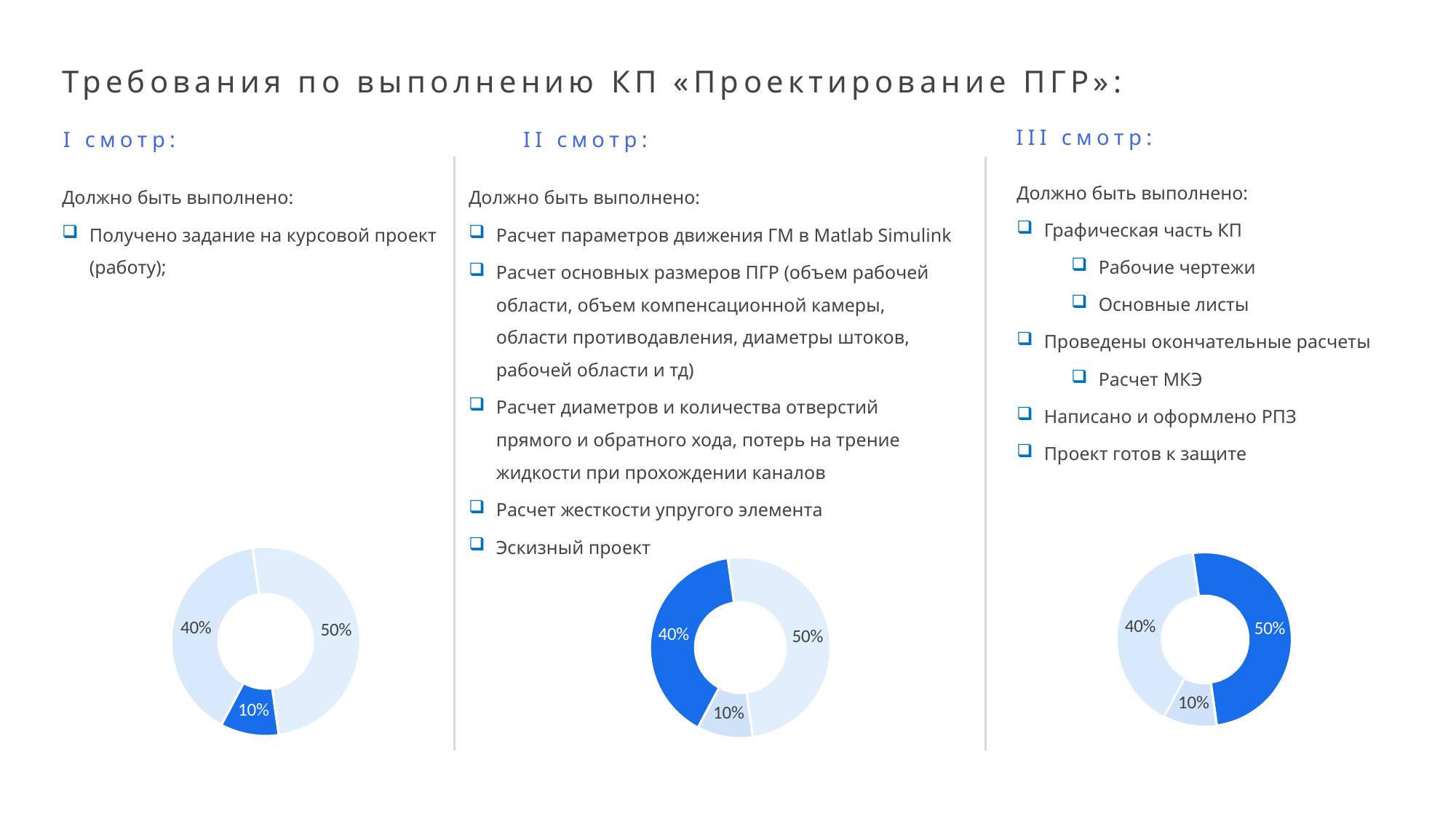
In the chart under 'III смотр', what is the difference between the 50% slice and the 40% slice? 10% In the chart under 'I смотр', what is the largest slice's share? 50% What kind of chart is shown under the 'I смотр' column? Donut (pie) chart In the chart under 'I смотр', how many slices does the donut have? 3 In the chart under 'I смотр', what is the smallest slice's share? 10% In the chart under 'II смотр', is the 40% slice larger or smaller than the 50% slice? smaller In the chart under 'II смотр', which slice is highlighted in dark blue? 40% In the chart under 'II смотр', what is the difference between the largest and smallest slices? 40% In the chart under 'III смотр', what is the share of the dark blue slice? 50% How many donut charts are shown on the slide? 3 In the chart under 'III смотр', what do the three slices add up to? 100% In the chart under 'I смотр', which slice is highlighted in dark blue? 10%